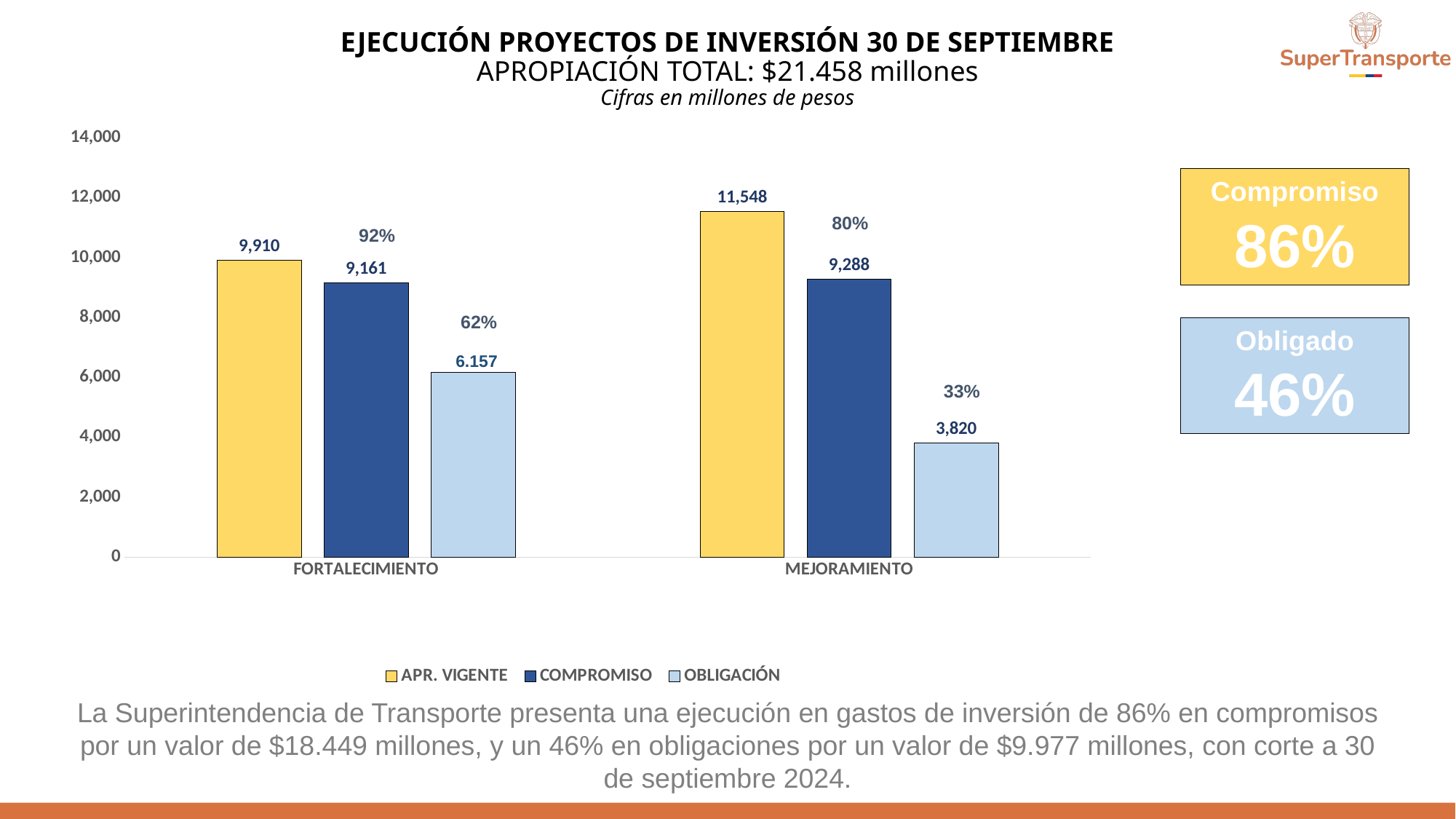
What kind of chart is shown on the slide? Bar chart What percentage is shown above the COMPROMISO bar for FORTALECIMIENTO? 92% What is the COMPROMISO value for MEJORAMIENTO? 9,288 Is the COMPROMISO value for FORTALECIMIENTO greater or less than the COMPROMISO value for MEJORAMIENTO? less What is the difference between the APR. VIGENTE values for MEJORAMIENTO and FORTALECIMIENTO? 1,638 Is the OBLIGACIÓN value for FORTALECIMIENTO greater or less than 6,000? greater What percentage is shown above the OBLIGACIÓN bar for MEJORAMIENTO? 33% Which bar is the lowest in the chart? OBLIGACIÓN for MEJORAMIENTO Which category has the higher APR. VIGENTE value? MEJORAMIENTO What is the OBLIGACIÓN value for MEJORAMIENTO? 3,820 What is the APR. VIGENTE value for FORTALECIMIENTO? 9,910 How many series does the legend list? 3